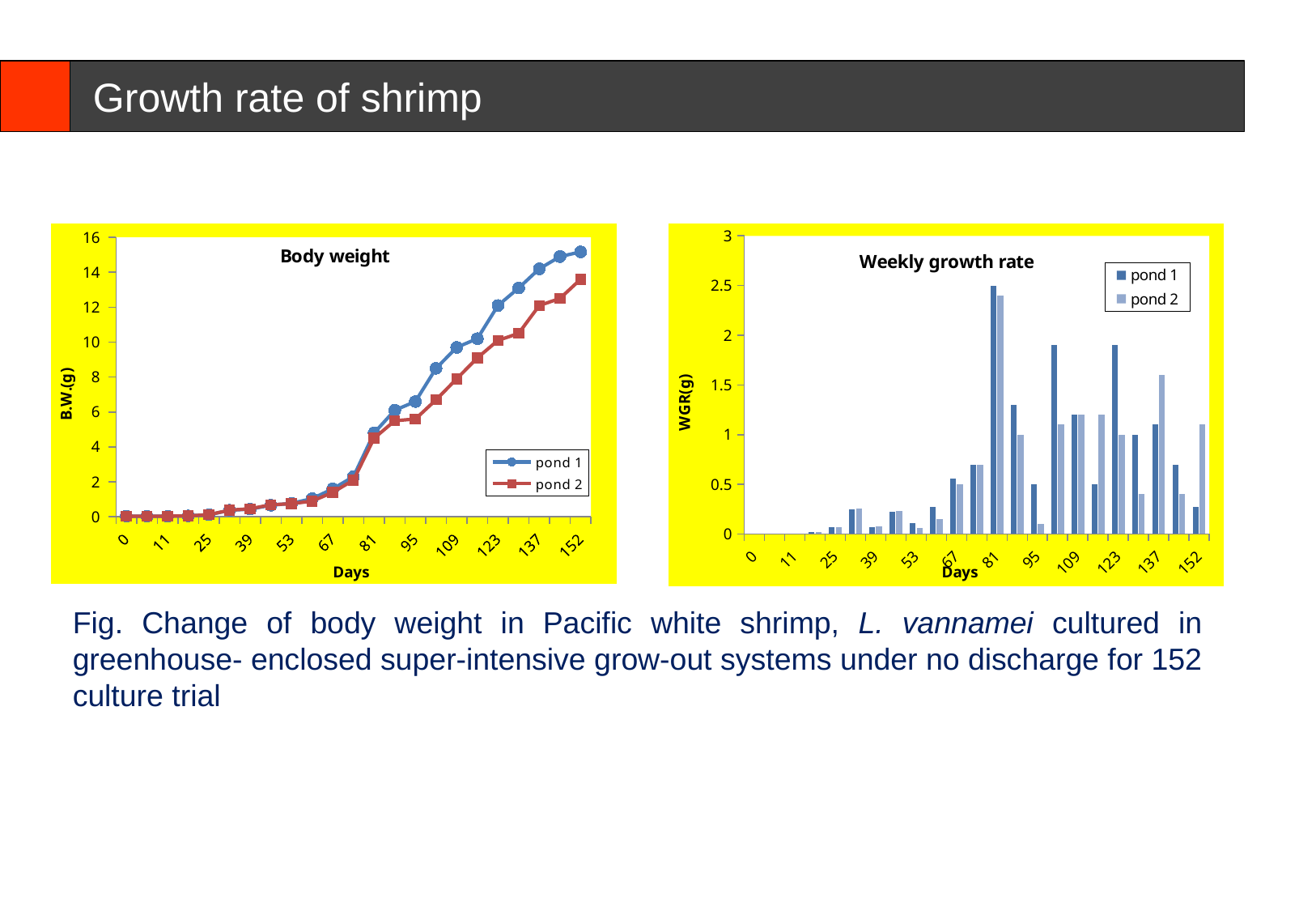
In the Body weight chart, is the value for pond 2 at day 152 greater or less than 14? less In the Body weight chart, how many series does the legend list? 2 In the Body weight chart, do the body weight values rise or fall as the days increase? rise What kind of chart is the Body weight chart on the left? line chart In the Weekly growth rate chart, is the value for pond 1 at day 81 greater or less than 2? greater In the Weekly growth rate chart, at which day does pond 1 reach its highest weekly growth rate? 81 What is the y-axis label of the Weekly growth rate chart? WGR(g) In the Weekly growth rate chart, which pond has the larger value at day 137? pond 2 In the Weekly growth rate chart, is the value for pond 1 at day 109 greater or less than 1.5? less In the Body weight chart, which pond has the larger body weight at day 152? pond 1 What kind of chart is the Weekly growth rate chart on the right? bar chart